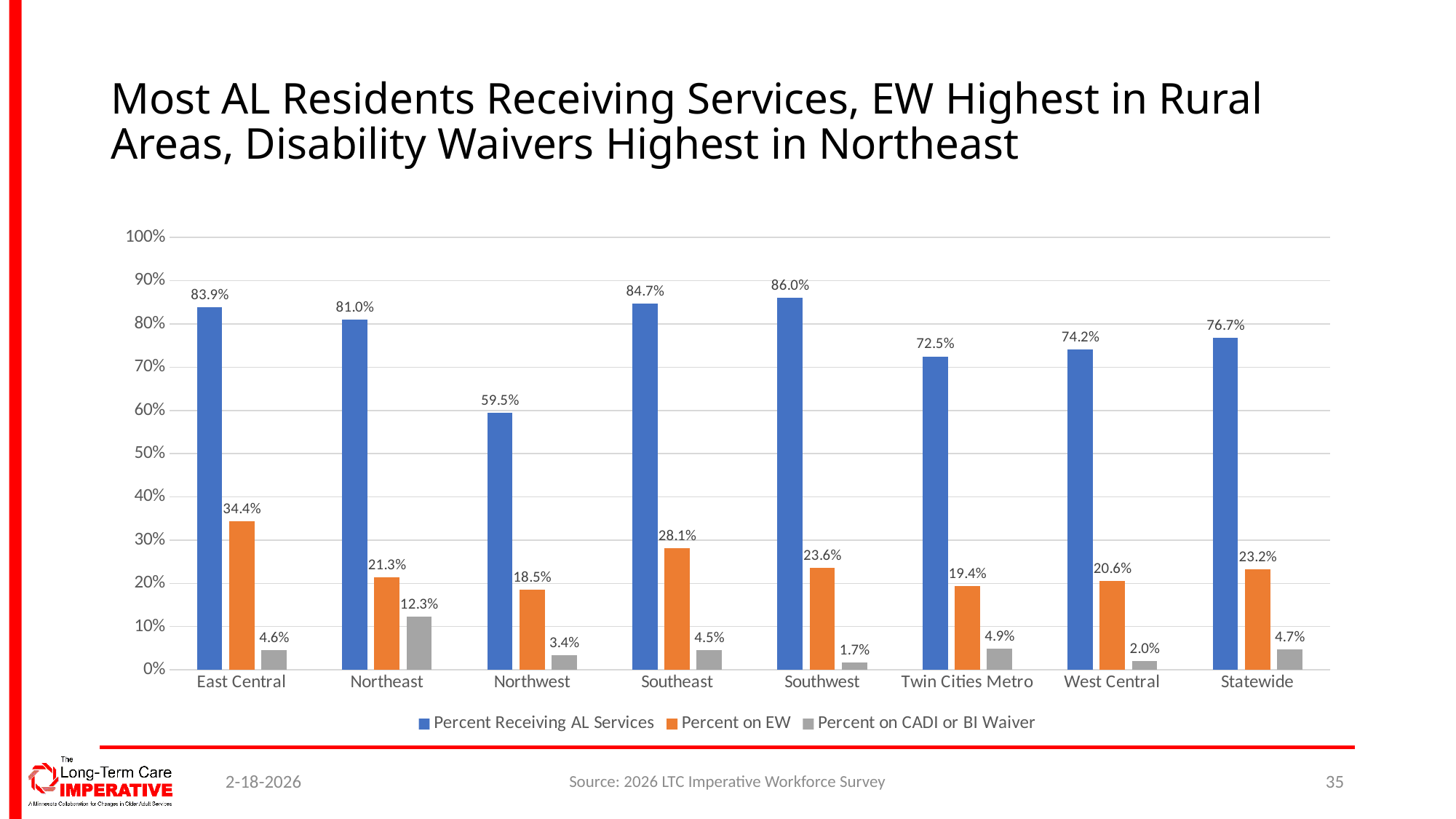
What kind of chart is shown on the slide? Bar chart What is the Percent Receiving AL Services for Northwest? 59.5% Which is larger, the Percent Receiving AL Services for Twin Cities Metro or for West Central? West Central Is the Percent Receiving AL Services for Statewide greater or less than 80%? less What is the Percent on EW for East Central? 34.4% Which colour represents Percent on EW in the chart? Orange What is the Percent on CADI or BI Waiver for Northeast? 12.3% What is the difference between the Percent on EW for East Central and for Southeast? 6.3% How many categories are shown on the x axis? 8 Which region has the lowest Percent on CADI or BI Waiver? Southwest Which region has the highest Percent Receiving AL Services? Southwest How many series does the legend list? 3